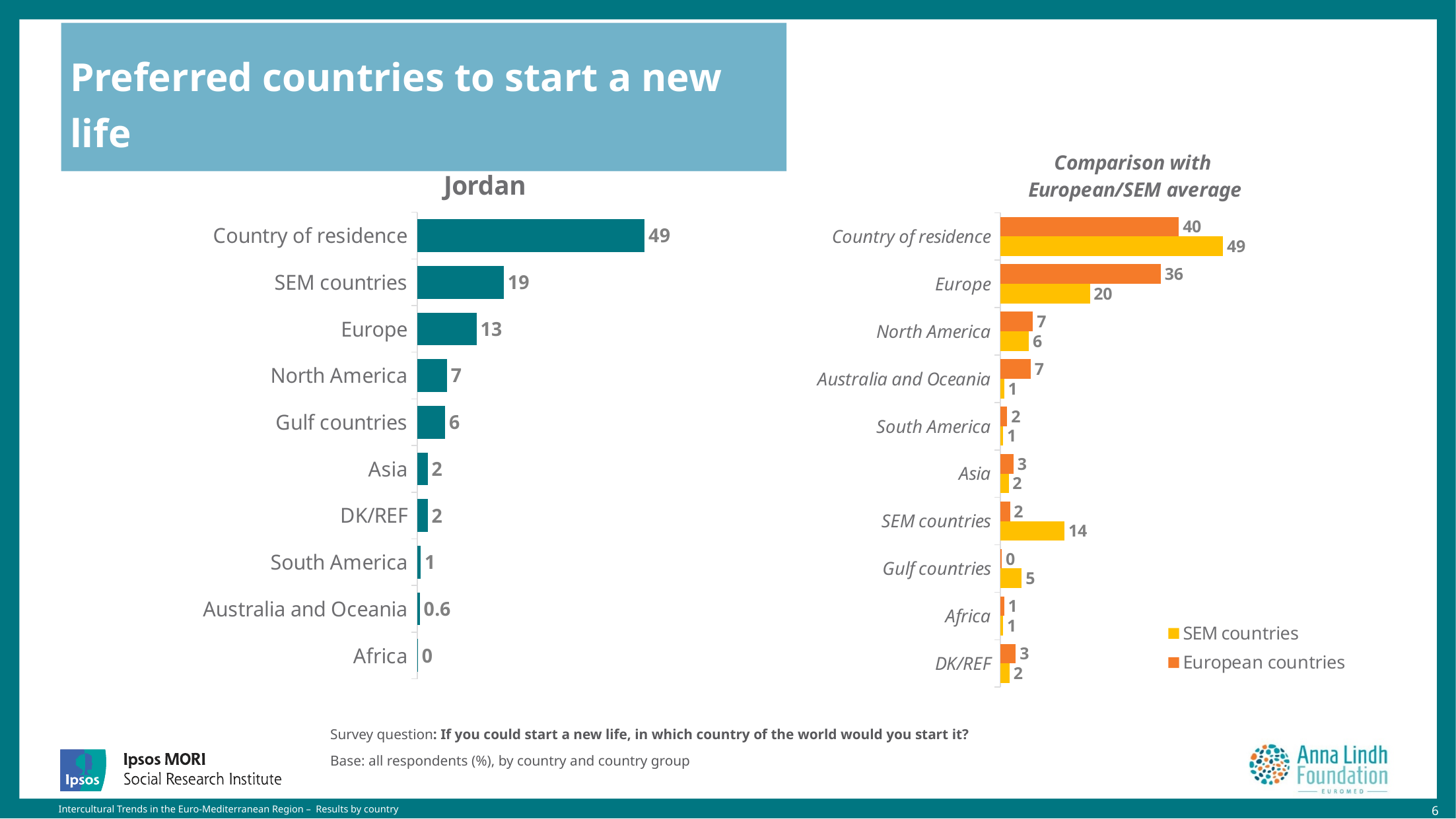
In the Jordan chart, what is the difference between the values for SEM countries and Europe? 6 In the Jordan chart, how many categories are shown? 10 What kind of chart is the Jordan chart? Bar chart In the Jordan chart, which category has the highest value? Country of residence In the Comparison with European/SEM average chart, what is the value for Europe for European countries? 36 In the Jordan chart, what is the value for SEM countries? 19 In the Comparison with European/SEM average chart, which is larger for Country of residence: SEM countries or European countries? SEM countries In the Jordan chart, which category has the lowest value? Africa In the Comparison with European/SEM average chart, how many series does the legend list? 2 In the Comparison with European/SEM average chart, what is the value for SEM countries for the SEM countries series? 14 In the Jordan chart, what is the value for Australia and Oceania? 0.6 In the Comparison with European/SEM average chart, what is the difference between the European countries and SEM countries values for Europe? 16